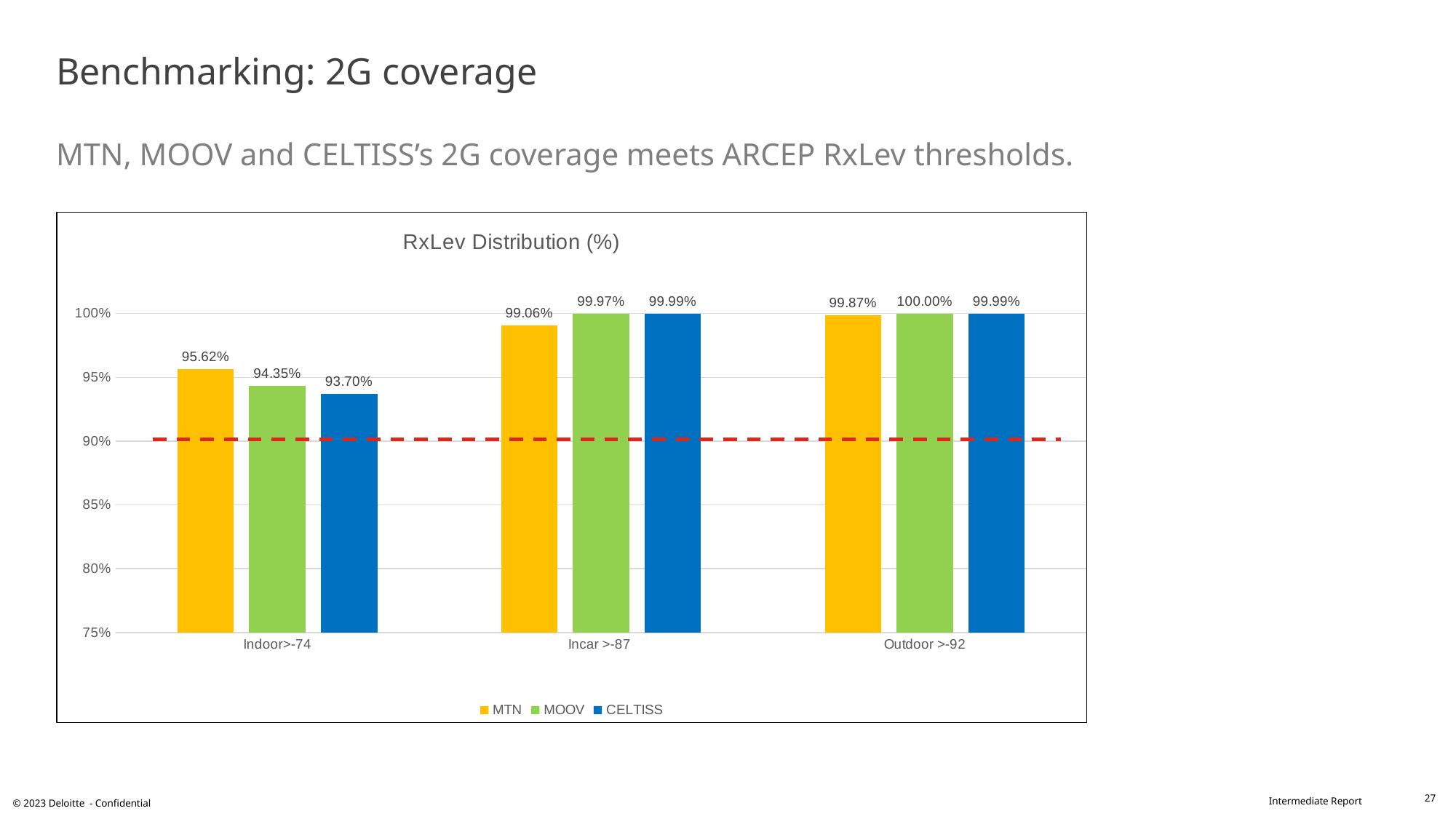
Which operator has the lowest value in the Indoor>-74 category? CELTISS What is the value for CELTISS in the Incar >-87 category? 99.99% What is the value for MOOV in the Outdoor >-92 category? 100.00% How many series does the legend list? 3 Which is larger in the Incar >-87 category: MTN or MOOV? MOOV What is the difference between MTN and MOOV in the Indoor>-74 category? 1.27% How many categories are shown on the x axis? 3 Is the value for CELTISS in the Indoor>-74 category greater or less than 90%? greater What is the value for MTN in the Indoor>-74 category? 95.62% What kind of chart is shown on the slide? Bar chart What is the title of the chart? RxLev Distribution (%) Which operator has the highest value in the Indoor>-74 category? MTN